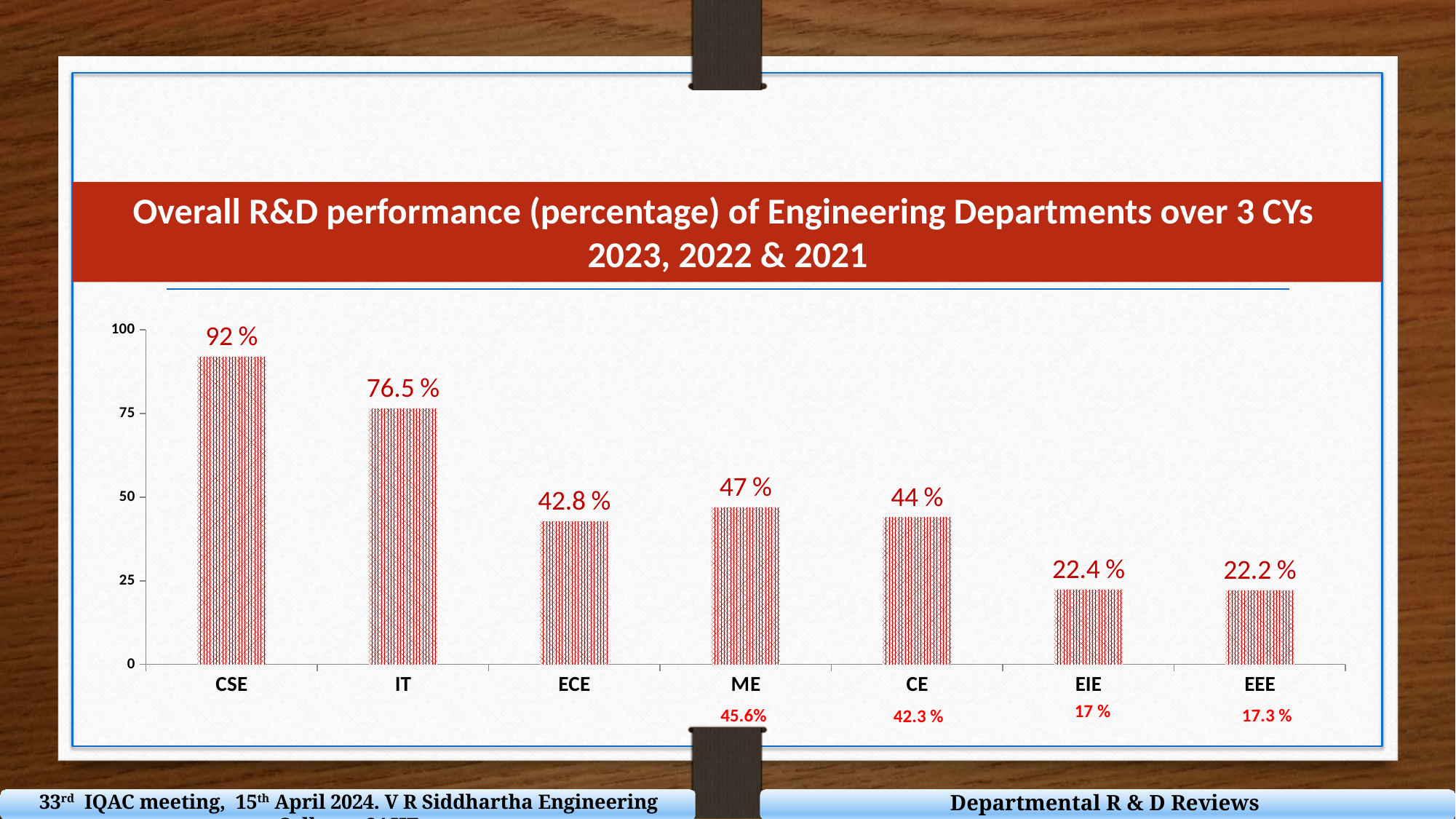
What value is shown above the ECE bar? 42.8 % What is the difference between the values for ME and CE? 3 % What is the R&D performance value shown for CSE? 92 % Which department has the lowest R&D performance percentage according to the bar labels? EEE How many departments are shown on the x axis of the chart? 7 What is the value labelled on the EIE bar? 22.4 % What kind of chart is used on this slide? bar chart Is the value for ECE greater or less than 50? less What is the difference between the values for CSE and IT? 15.5 % What is the value labelled on the bar for IT? 76.5 % Which department has the highest R&D performance percentage? CSE Which has a larger value, ME or CE? ME